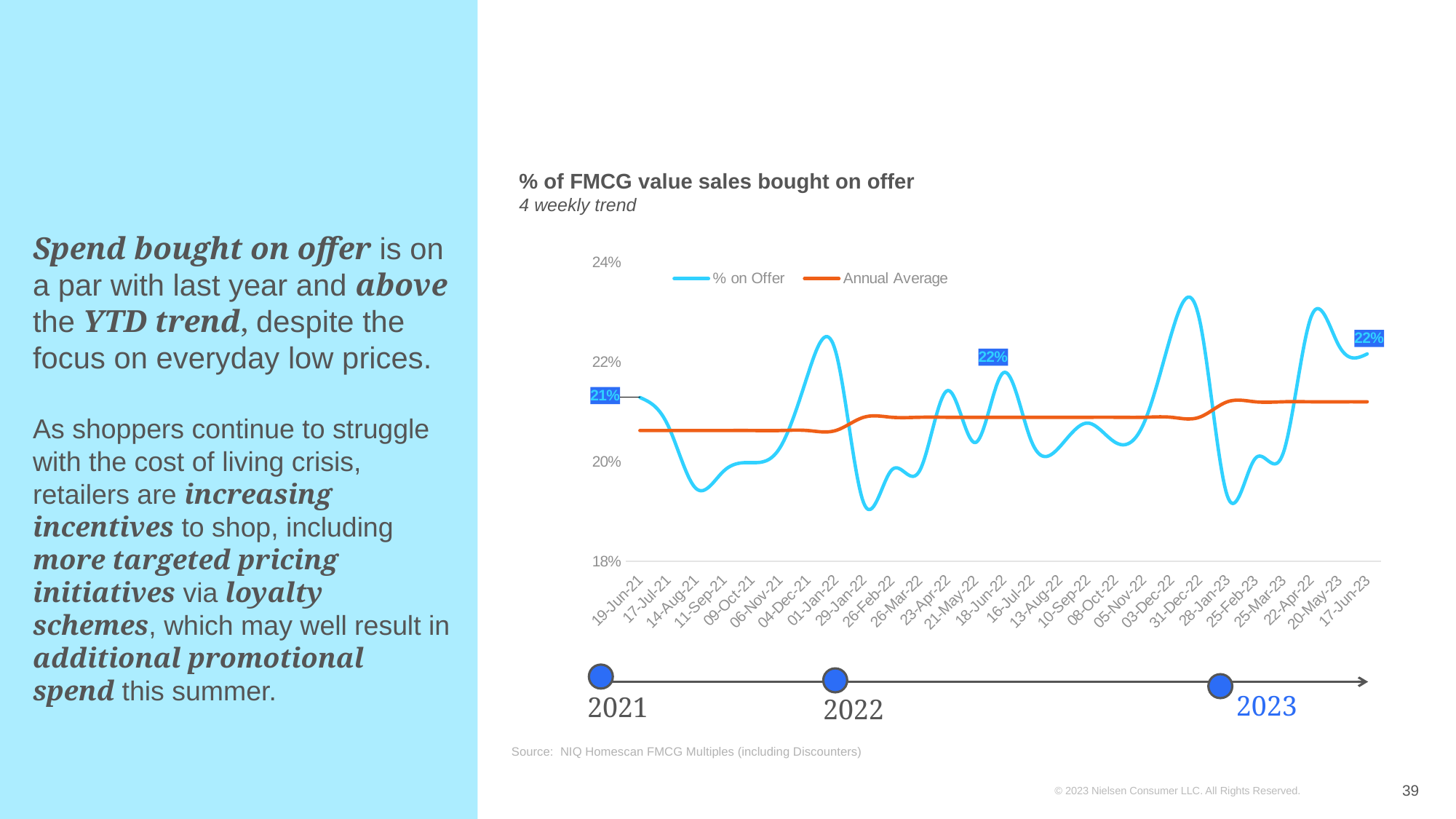
Is the value for % on Offer at 29-Jan-22 greater or less than 20%? less What is the labelled value of % on Offer at 19-Jun-21? 21% What is the labelled value of % on Offer at 17-Jun-23? 22% Which is larger, the % on Offer value at 03-Dec-22 or at 29-Jan-22? 03-Dec-22 What is the labelled value of % on Offer at 18-Jun-22? 22% Is the Annual Average line at 17-Jun-23 greater or less than 22%? less What are the two series named in the chart legend? % on Offer and Annual Average Is the value for % on Offer at 03-Dec-22 greater or less than 22%? greater How many date labels are shown on the x axis? 27 What is the title of the chart? % of FMCG value sales bought on offer How many series does the chart legend list? 2 What kind of chart is shown on the slide? line chart